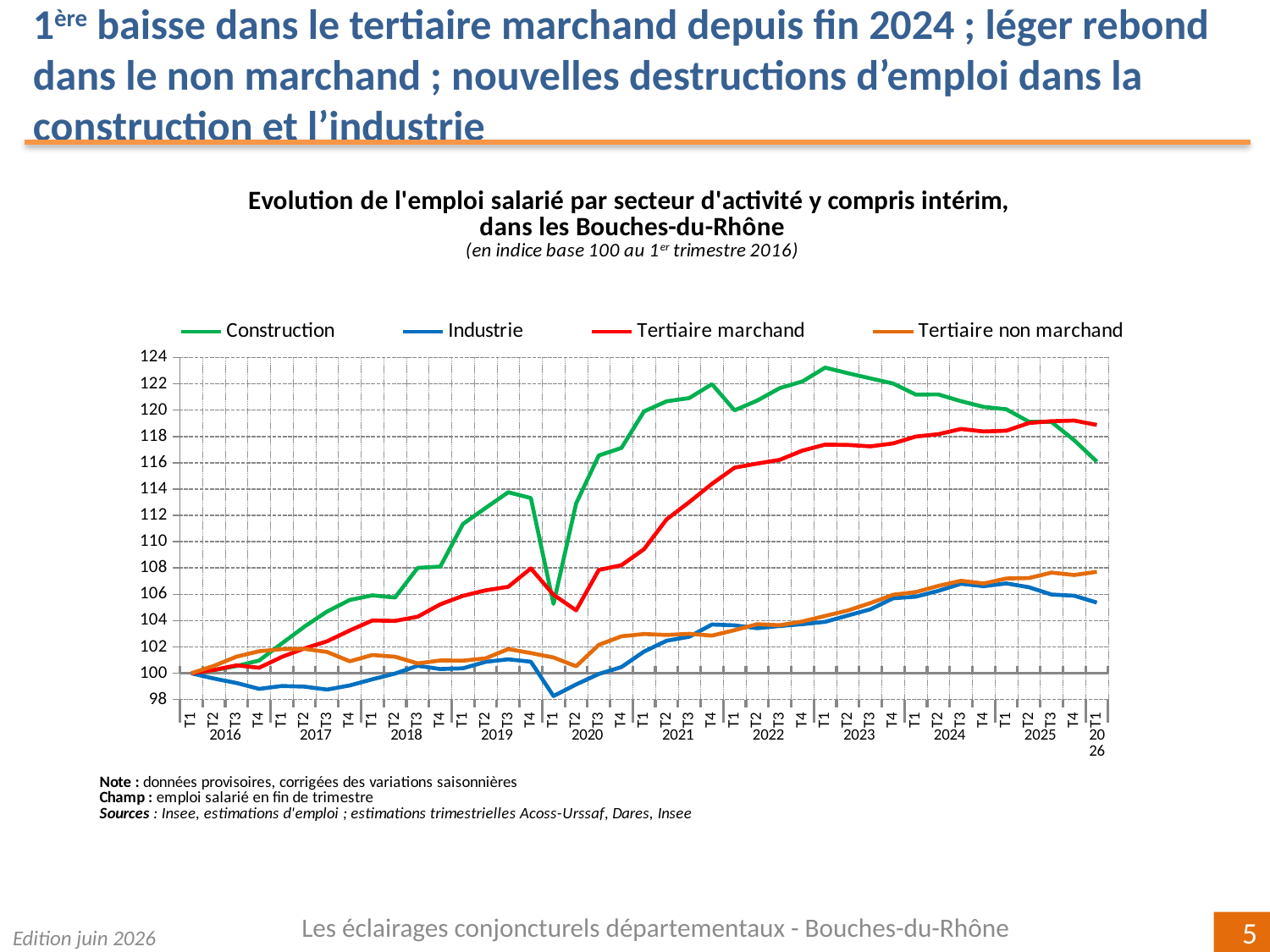
Is the value for Industrie at T1 2020 greater or less than 100? less What kind of chart is shown on the slide? line chart Which series has the lowest value at T1 2026? Industrie Which series reaches the highest value anywhere on the chart? Construction Which series has the highest value at T1 2026? Tertiaire marchand Does the Construction series rise or fall between T1 2023 and T1 2026? fall Which series are listed in the legend? Construction, Industrie, Tertiaire marchand, Tertiaire non marchand Is the value for Construction at T1 2023 greater or less than 122? greater How many series does the legend list? 4 At T1 2023, which is higher: Construction or Tertiaire marchand? Construction Is the value for Construction at T1 2026 greater or less than 114? greater What is the index value of all series at T1 2016? 100